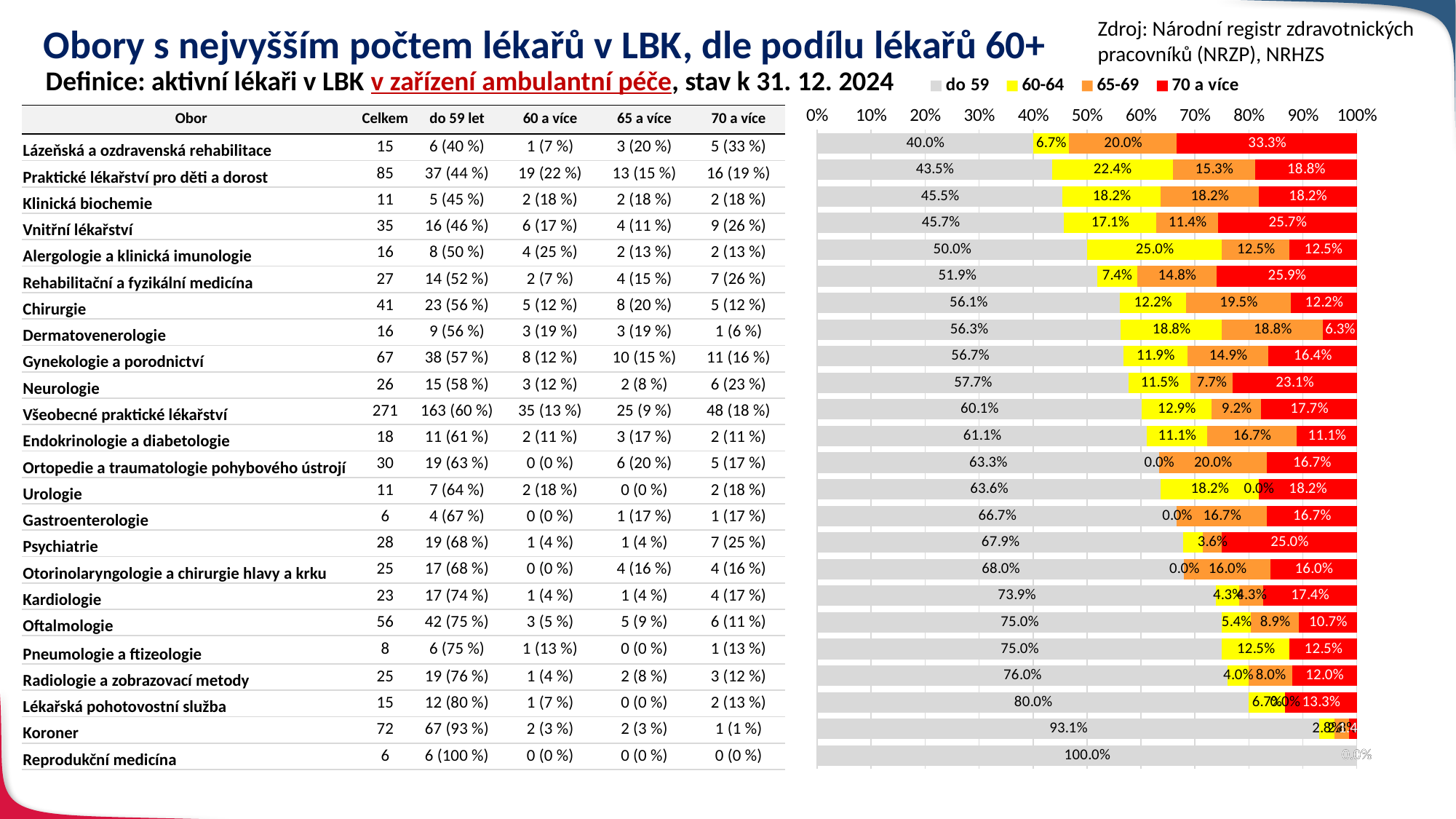
How many series does the chart legend list? 4 Which bar in the chart has the largest 'do 59' segment? the bottom bar (100.0%) In the fifth bar from the top of the chart, which is larger: the '60-64' share or the '70 a více' share? 60-64 (25.0%) In the chart, what is the 'do 59' share shown on the bottom bar? 100.0% Which bar in the chart has the largest '70 a více' segment? the top bar (33.3%) In the chart, what is the 'do 59' share shown on the top bar? 40.0% What kind of chart is shown on the right side of the slide? stacked bar chart How many bars are plotted in the chart? 24 Does the 'do 59' share rise or fall going from the top bar to the bottom bar of the chart? rises In the top bar of the chart, how much larger is the '70 a více' share than the '60-64' share? 26.6 percentage points In the chart, what is the '70 a více' share shown on the top bar? 33.3% In the chart, what is the '60-64' share shown on the second bar from the top? 22.4%